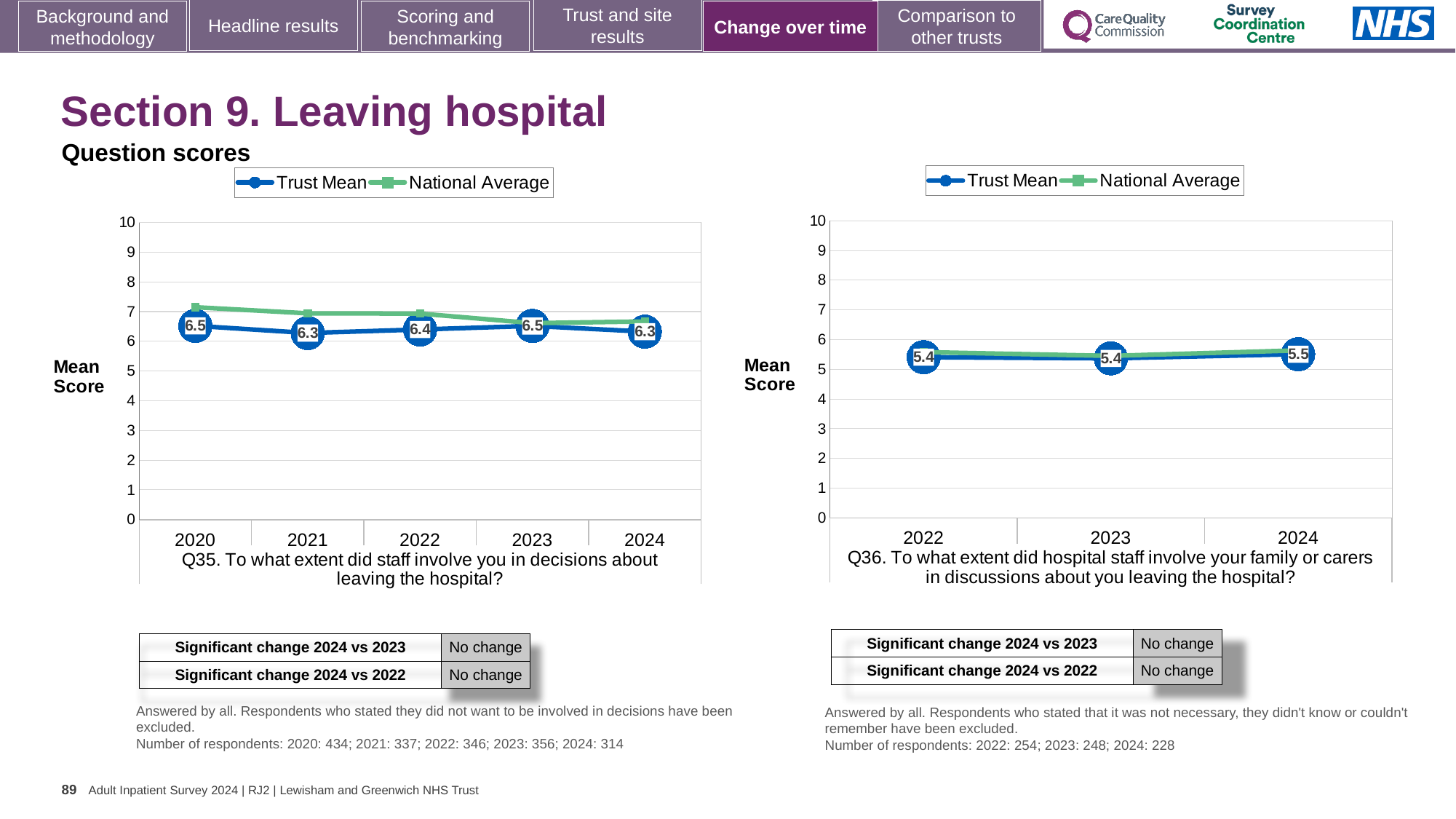
In the Q35 chart on the left, what is the difference between the Trust Mean scores for 2023 and 2024? 0.2 How many years are plotted on the x axis of the Q35 chart on the left? 5 In the Q36 chart on the right, what is the Trust Mean score for 2022? 5.4 In the Q35 chart on the left, what is the Trust Mean score for 2021? 6.3 In the Q35 chart on the left, is the National Average value for 2020 greater or less than 8? less In the Q36 chart on the right, what is the Trust Mean score for 2024? 5.5 How many series does the legend of the Q36 chart on the right list? 2 In the Q35 chart on the left, is the Trust Mean score for 2022 larger or smaller than the score for 2023? smaller In the Q35 chart on the left, what is the Trust Mean score for 2020? 6.5 In the Q36 chart on the right, is the National Average value for 2022 greater or less than 6? less What type of chart is the Q35 chart on the left? Line chart In the Q36 chart on the right, which year has the highest Trust Mean score? 2024